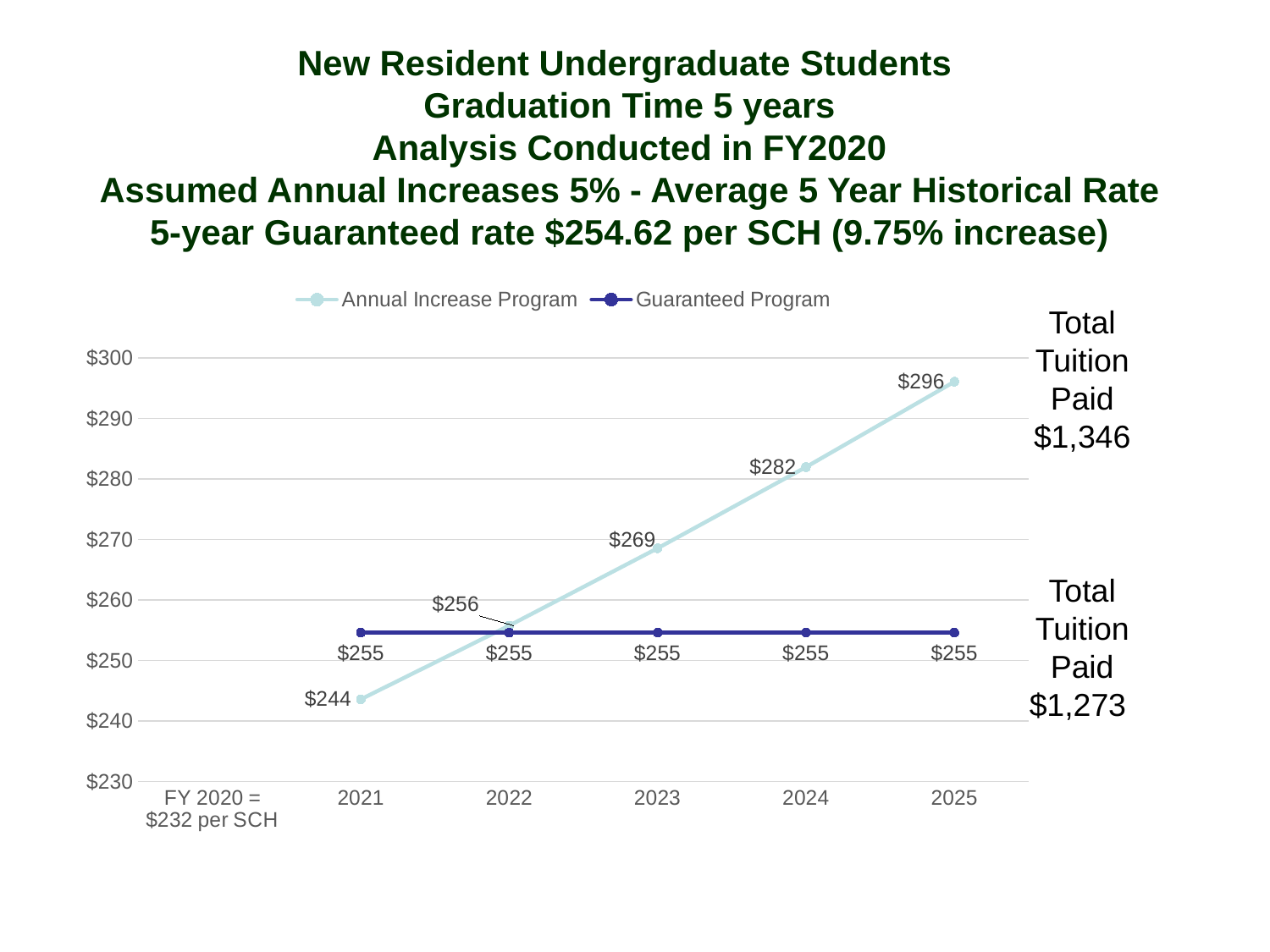
In which year is the Annual Increase Program value highest? 2025 What type of chart is shown on the slide? line chart How many series does the legend list? 2 What is the value for the Annual Increase Program in 2025? $296 What is the value for the Guaranteed Program in 2023? $255 What is the value for the Annual Increase Program in 2021? $244 In which year is the Annual Increase Program value lowest? 2021 What is the difference between the Annual Increase Program value in 2025 and in 2021? $52 Which is larger in 2024, the Annual Increase Program value or the Guaranteed Program value? Annual Increase Program What is the value for the Annual Increase Program in 2023? $269 Does the Annual Increase Program value rise or fall from 2021 to 2025? rise